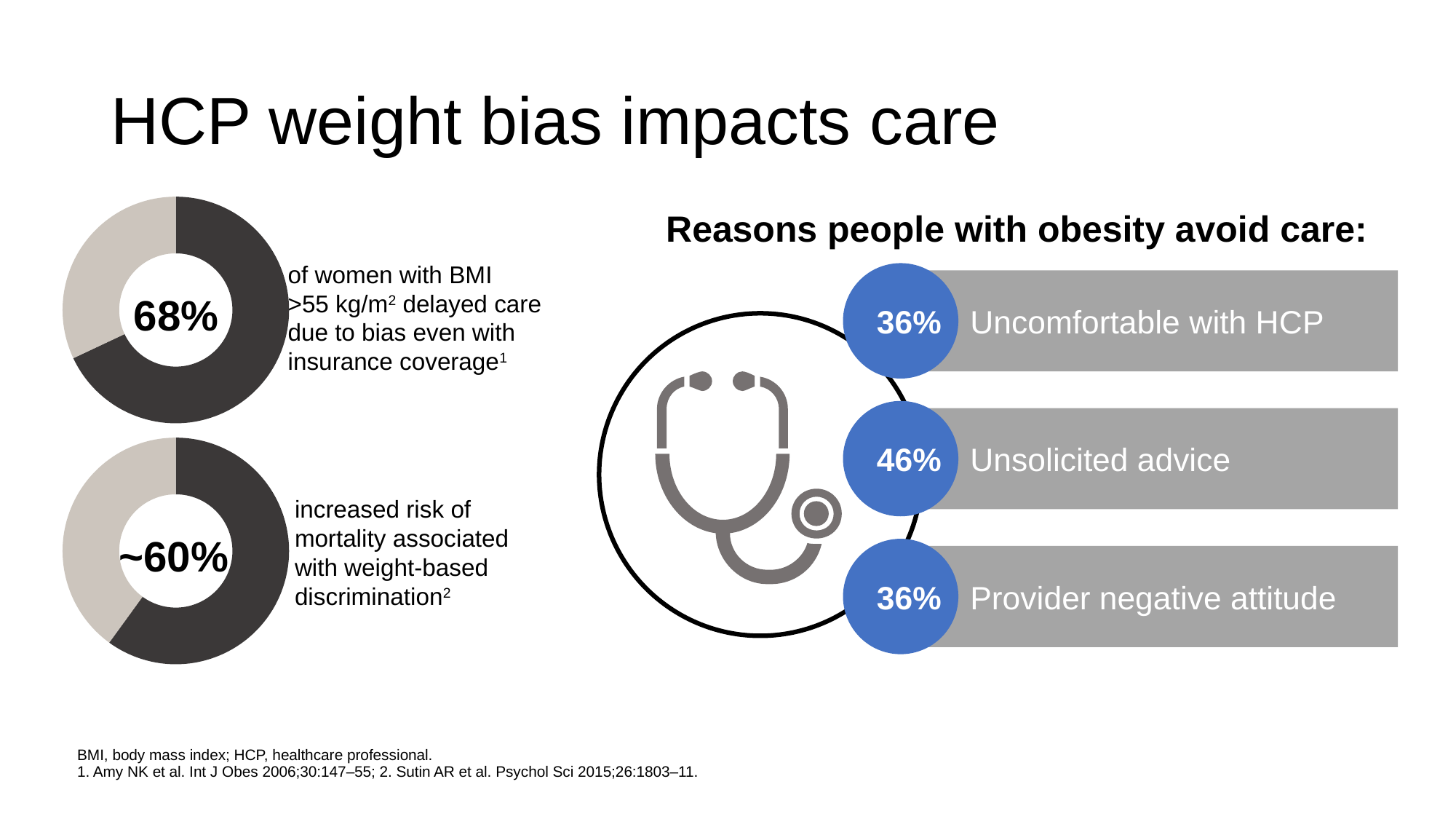
On the top donut chart on the left, what percentage is shown in the centre? 68% In the 'Reasons people with obesity avoid care' graphic, what percentage is given for 'Uncomfortable with HCP'? 36% In the 'Reasons people with obesity avoid care' graphic, what percentage is given for 'Provider negative attitude'? 36% In the 'Reasons people with obesity avoid care' graphic, which reason has the highest percentage? Unsolicited advice In the 'Reasons people with obesity avoid care' graphic, what is the difference between the percentage for 'Unsolicited advice' and 'Uncomfortable with HCP'? 10% On the bottom donut chart on the left, what value is shown in the centre? ~60% What is the title of the graphic on the right side of the slide? Reasons people with obesity avoid care: In the 'Reasons people with obesity avoid care' graphic, what percentage is given for 'Unsolicited advice'? 46% How many donut charts are shown on the left side of the slide? 2 In the 'Reasons people with obesity avoid care' graphic, how many reasons are listed? 3 In the 'Reasons people with obesity avoid care' graphic, which is larger: the percentage for 'Unsolicited advice' or for 'Provider negative attitude'? Unsolicited advice What kind of chart is used on the left side of the slide to show the 68% figure? Donut chart